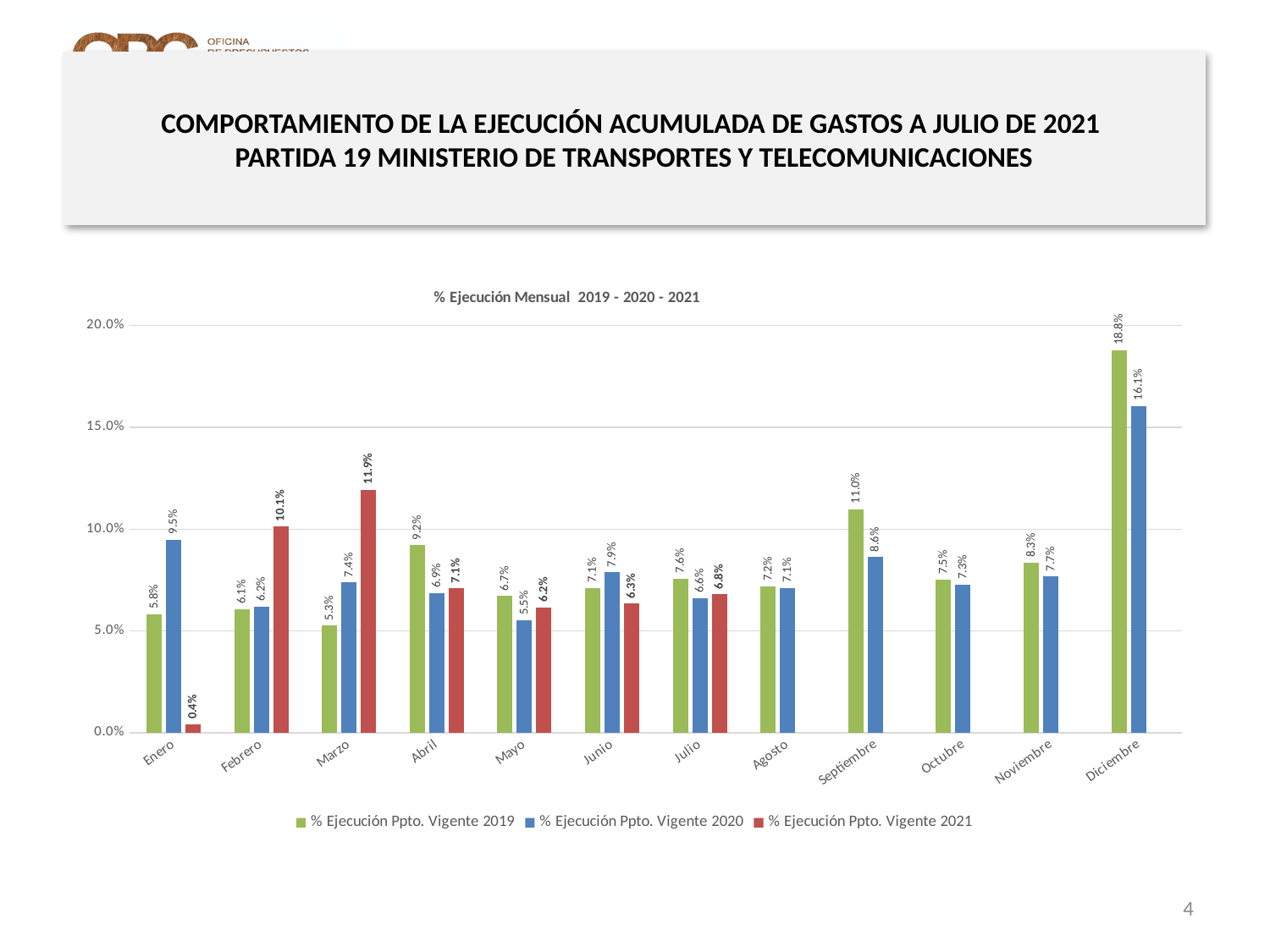
Which month has the lowest value for % Ejecución Ppto. Vigente 2021? Enero In Abril, which is larger: the 2019 value or the 2021 value? 2019 What is the value for % Ejecución Ppto. Vigente 2019 in Diciembre? 18.8% How many series does the legend list? 3 Is the value for % Ejecución Ppto. Vigente 2019 in Septiembre greater or less than 10.0%? greater Which month has the highest value for % Ejecución Ppto. Vigente 2020? Diciembre What is the difference between the 2019 and 2020 values in Diciembre? 2.7% What is the value for % Ejecución Ppto. Vigente 2021 in Marzo? 11.9% What kind of chart is shown on the slide? Bar chart What is the value for % Ejecución Ppto. Vigente 2020 in Enero? 9.5% How many months are shown on the x axis? 12 What is the title of the chart? % Ejecución Mensual 2019 - 2020 - 2021